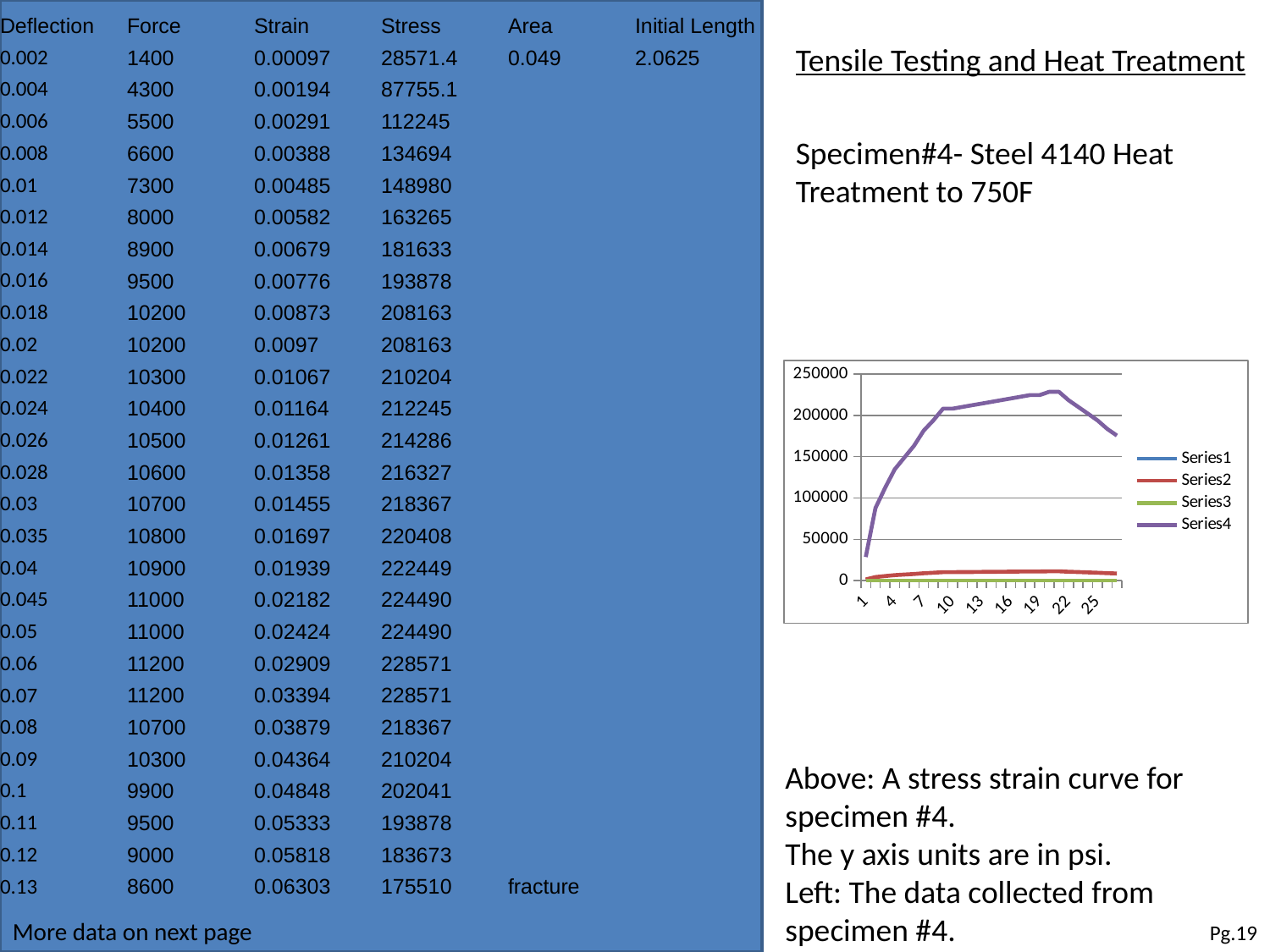
What kind of chart is shown on the slide? line chart Is the value of Series4 at x = 1 greater or less than 50000? less Is the final value of Series4 (at the right end of the chart) greater or less than 150000? greater Which series in the chart reaches the highest values? Series4 How many series does the chart legend list? 4 Is the value of Series2 at x = 13 greater or less than 50000? less What is the highest value labelled on the chart's y axis? 250000 What colour is the line for Series4 in the chart? purple Does Series4 rise or fall between x = 1 and x = 10? rise Does Series4 rise or fall between x = 22 and the right end of the chart? fall